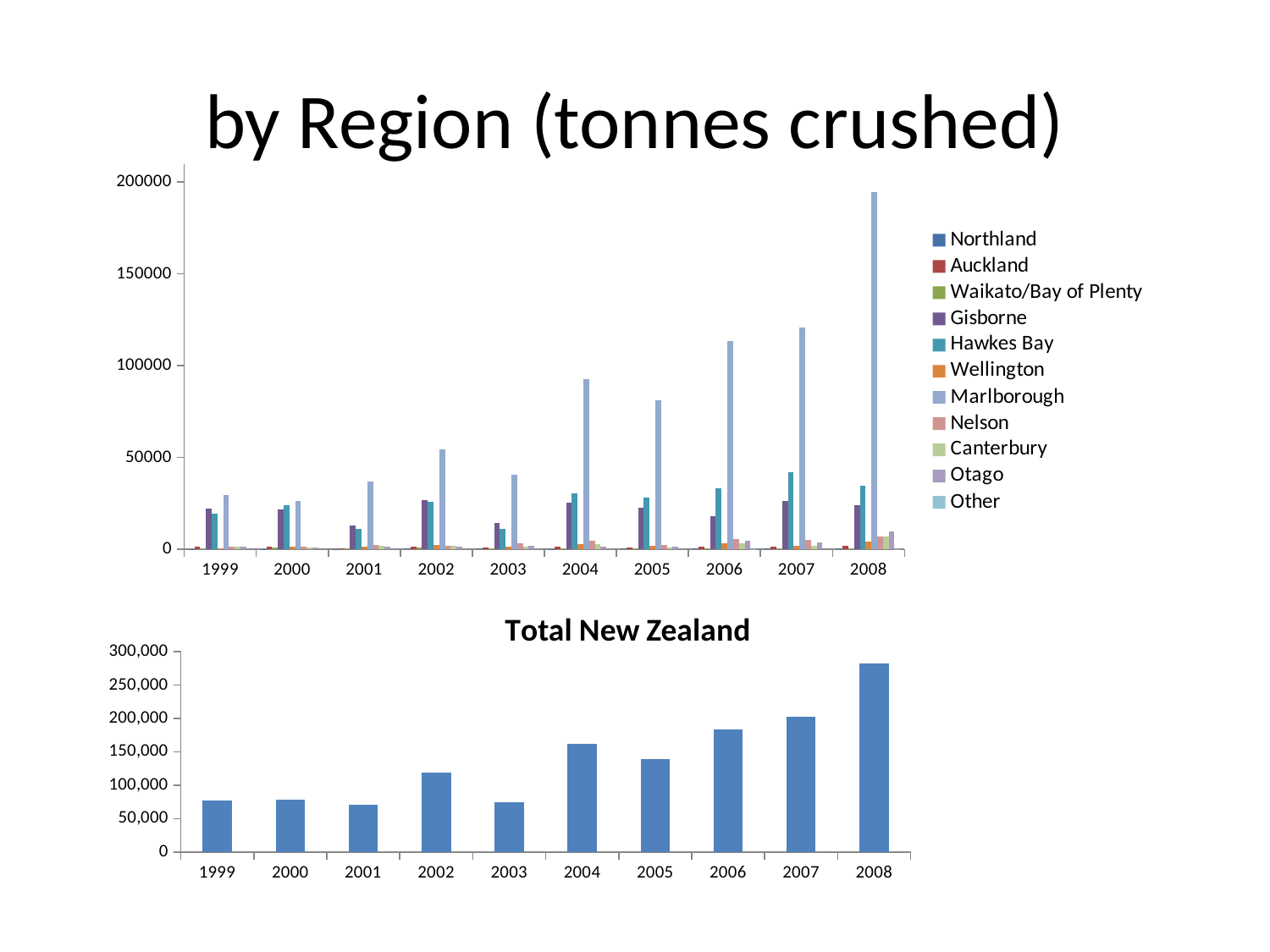
What kind of chart is the 'Total New Zealand' chart at the bottom of the slide? bar chart In the 'Total New Zealand' chart, which is larger, the value for 2004 or the value for 2005? 2004 How many years are shown on the x axis of the 'Total New Zealand' chart? 10 In the top 'by Region (tonnes crushed)' chart, is the Hawkes Bay value for 2007 greater or less than 50000? less How many series does the legend of the top 'by Region (tonnes crushed)' chart list? 11 In the top 'by Region (tonnes crushed)' chart, is the Marlborough value for 2004 greater or less than 100000? less In the top 'by Region (tonnes crushed)' chart, is the Marlborough value for 2008 greater or less than 150000? greater In the 'Total New Zealand' chart, which year has the highest value? 2008 In the top 'by Region (tonnes crushed)' chart, which region has the highest value in 2008? Marlborough